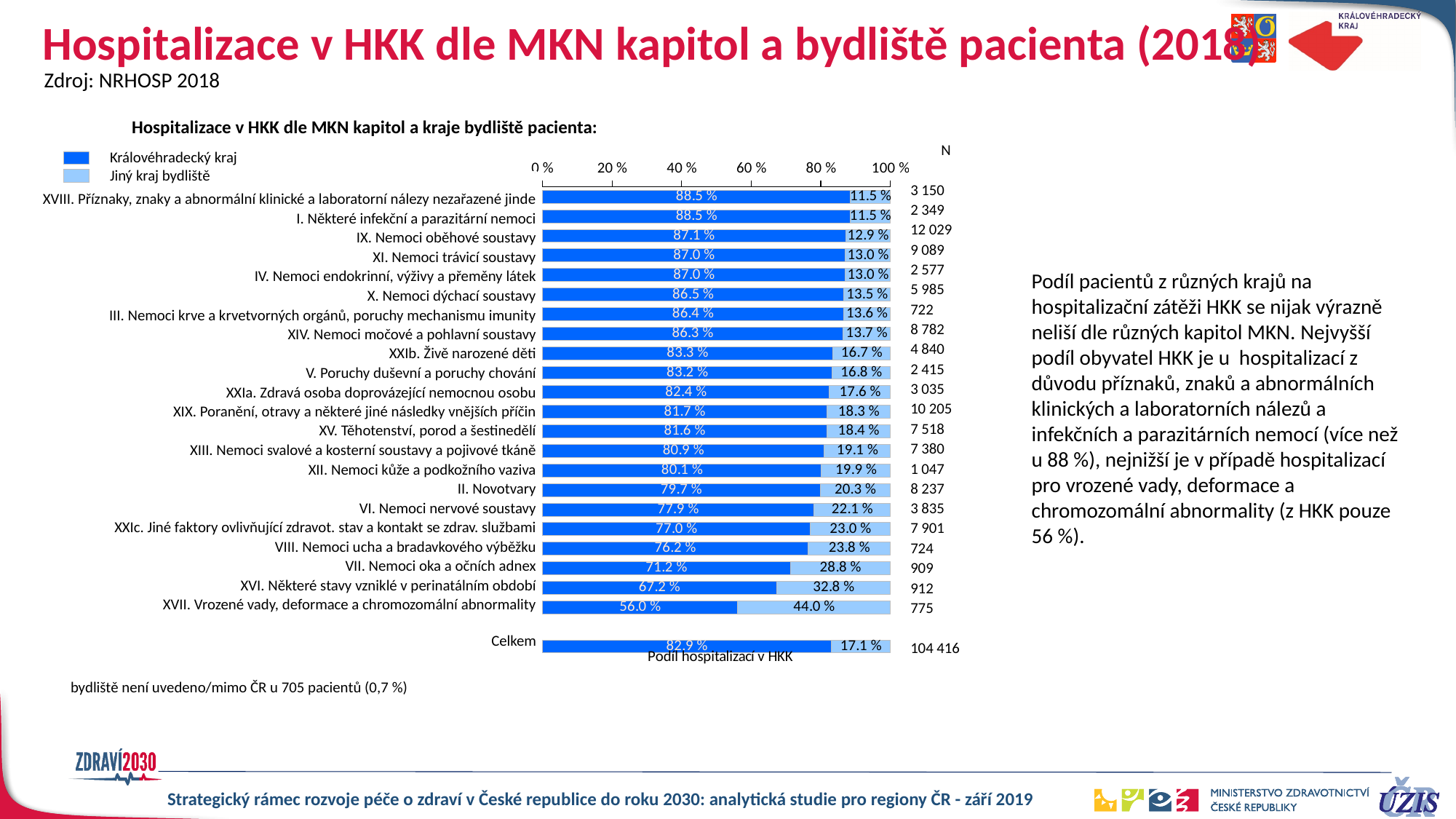
Is the Královéhradecký kraj share for 'XVI. Některé stavy vzniklé v perinatálním období' greater or less than 80 %? less Which MKN chapter has the lowest Královéhradecký kraj share? XVII. Vrozené vady, deformace a chromozomální abnormality Which has a larger Královéhradecký kraj share: 'IX. Nemoci oběhové soustavy' or 'VII. Nemoci oka a očních adnex'? IX. Nemoci oběhové soustavy What is the N value shown for 'IX. Nemoci oběhové soustavy'? 12 029 What kind of chart is shown on the slide? bar chart How many series does the chart legend list? 2 What is the Jiný kraj bydliště share for 'VII. Nemoci oka a očních adnex'? 28.8 % What is the Královéhradecký kraj share for the 'Celkem' bar? 82.9 % What is the difference between the Královéhradecký kraj share and the Jiný kraj bydliště share in the 'Celkem' bar? 65.8 percentage points How many MKN chapter categories are plotted, not counting the 'Celkem' bar? 22 What is the Královéhradecký kraj share for 'XVII. Vrozené vady, deformace a chromozomální abnormality'? 56.0 % Which MKN chapter has the highest Jiný kraj bydliště share? XVII. Vrozené vady, deformace a chromozomální abnormality